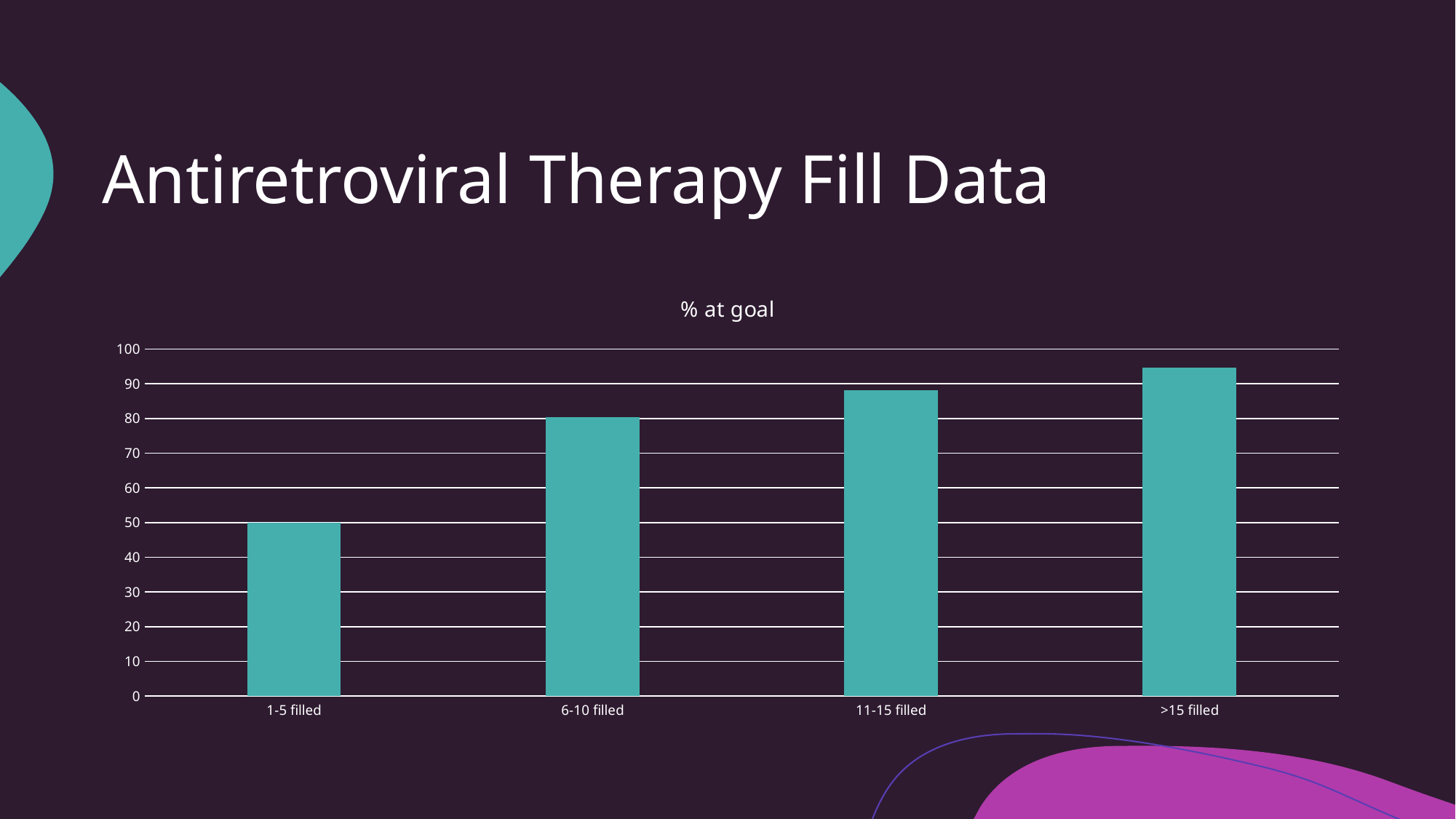
Is the value for 6-10 filled greater or less than 70? greater What is the value for 1-5 filled? 50 Which is larger, the value for 6-10 filled or the value for 11-15 filled? 11-15 filled Is the value for 11-15 filled greater or less than 80? greater Is the value for 1-5 filled greater or less than 60? less Which category has the highest value in the chart? >15 filled What is the title of the chart? % at goal What kind of chart is shown on the slide? bar chart Which category has the lowest value in the chart? 1-5 filled Do the values rise or fall from left to right along the x axis? rise How many categories are shown on the x axis of the chart? 4